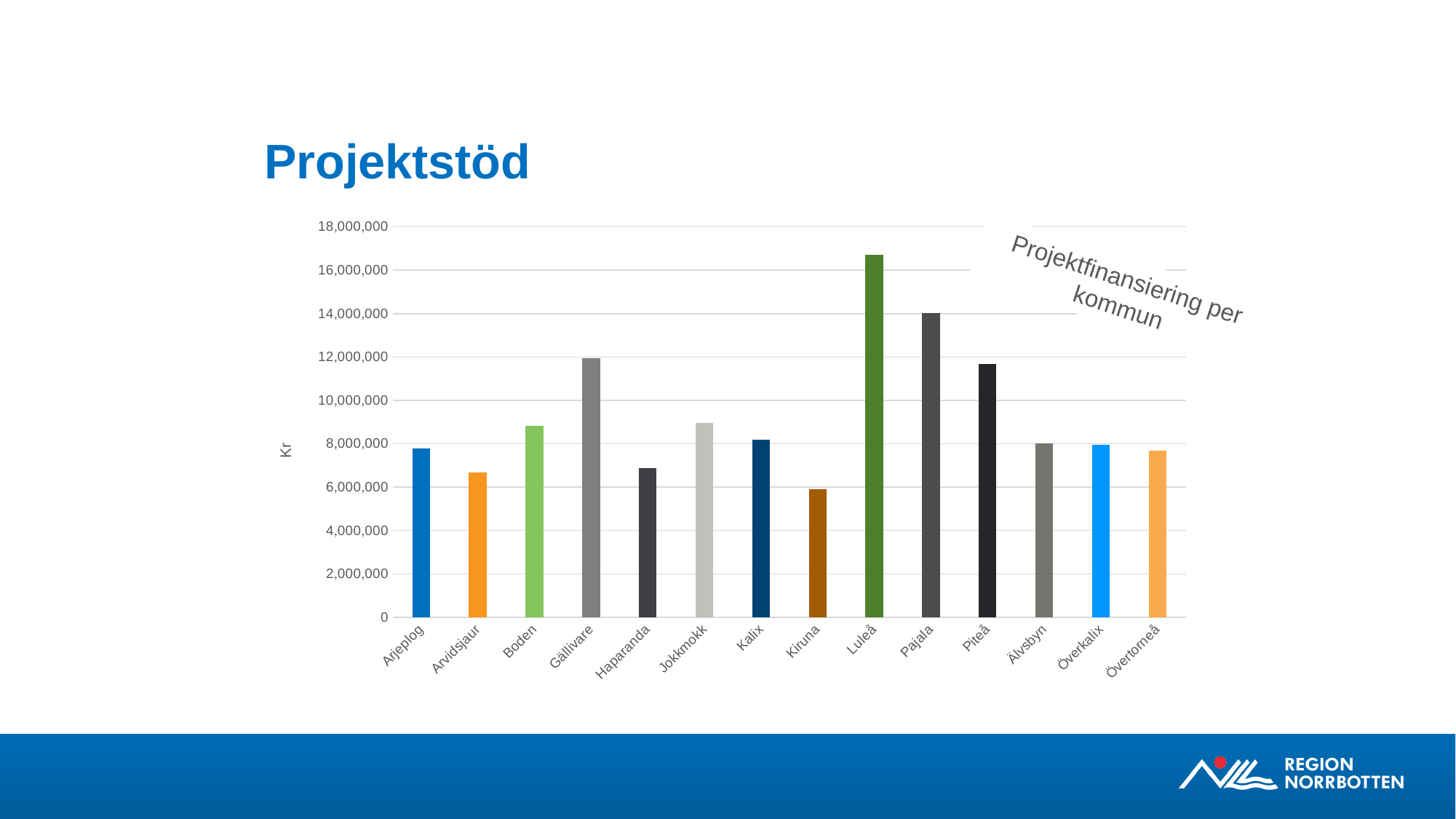
Which municipality has the lowest project funding in the chart? Kiruna Which municipality has the highest project funding in the chart? Luleå Which has the larger value, Gällivare or Boden? Gällivare What is the title of the chart? Projektfinansiering per kommun Is the value for Pajala greater or less than 12,000,000? greater Is the value for Luleå greater or less than 16,000,000? greater How many municipalities (categories) are shown on the x axis of the chart? 14 What kind of chart is shown on the slide? Bar chart Is the value for Gällivare greater or less than 10,000,000? greater Which has the larger value, Pajala or Piteå? Pajala